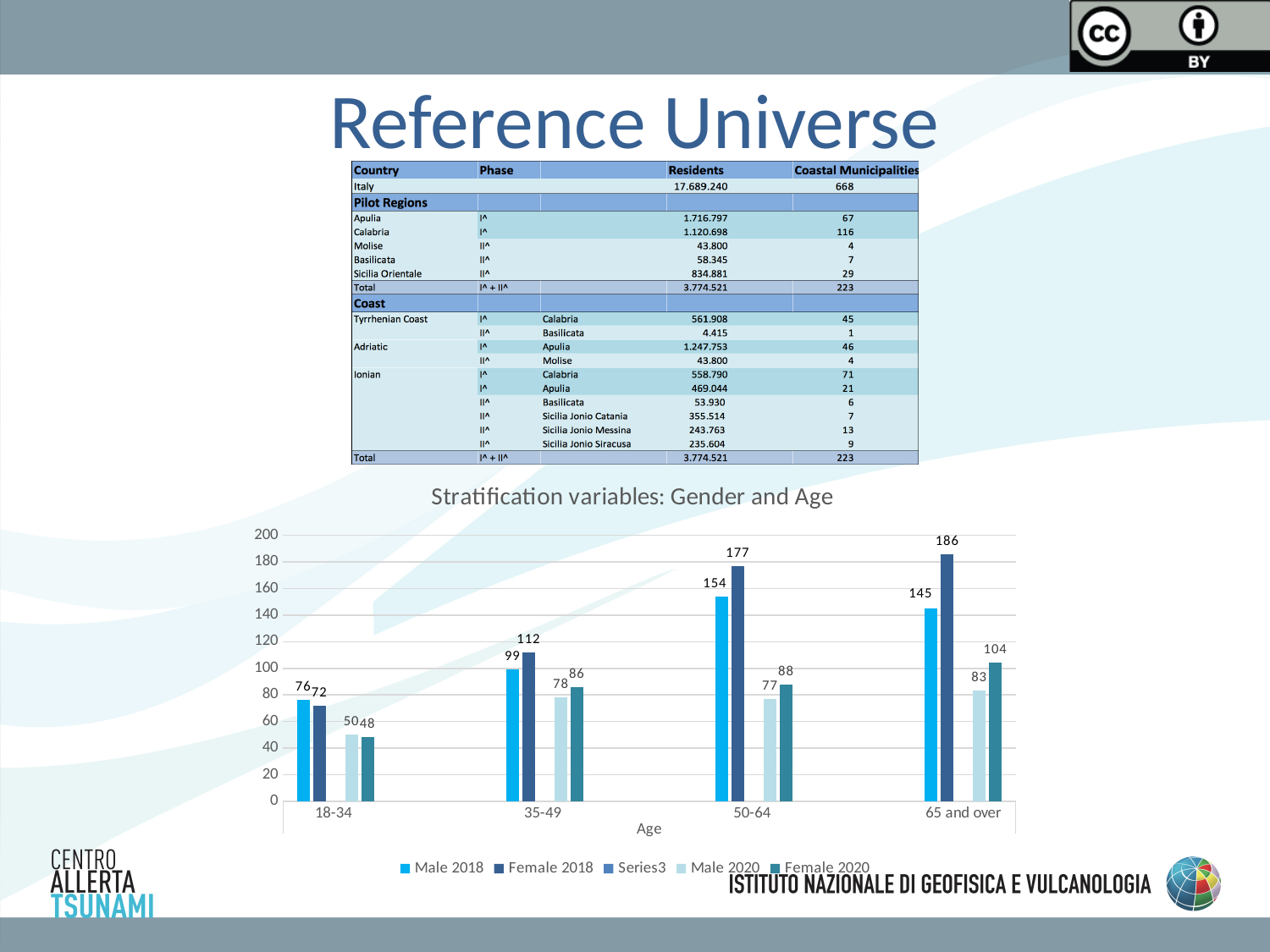
What is the difference between the Female 2018 and Male 2018 values for the 65 and over age group? 41 What is the value for Female 2018 in the 50-64 age group? 177 Is the Male 2018 value for the 50-64 age group greater or less than 140? greater What is the title of the x axis of the chart? Age How many series does the chart legend list? 5 Which age group has the highest Female 2018 value? 65 and over Which age group has the lowest Male 2018 value? 18-34 What is the value for Male 2020 in the 35-49 age group? 78 Which is larger in the 18-34 age group: Male 2018 or Female 2018? Male 2018 What is the value for Female 2020 in the 65 and over age group? 104 What kind of chart is shown on the slide? bar chart How many age groups are shown on the x axis of the chart? 4